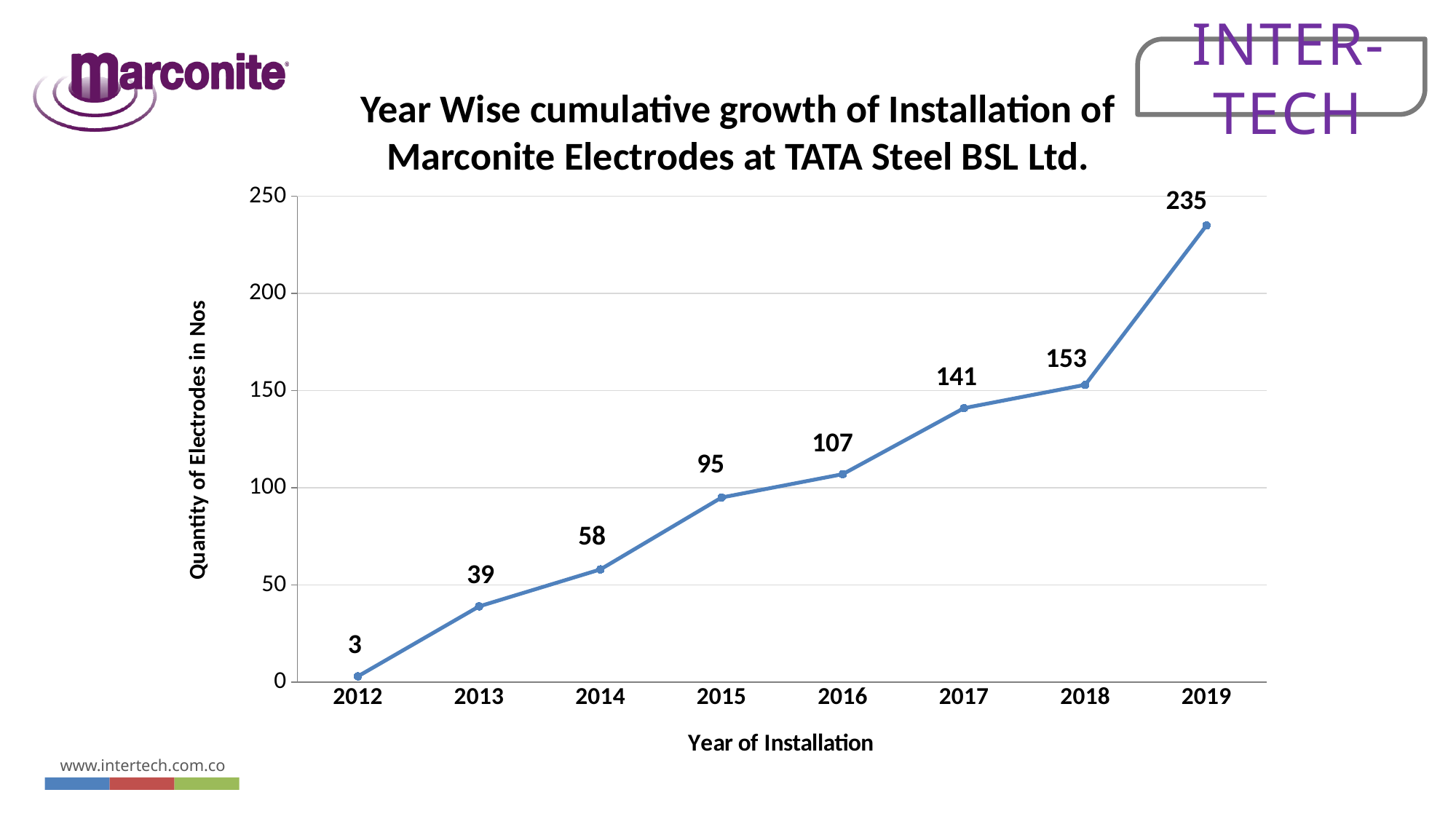
How many years are plotted on the x axis? 8 Which is larger, the value for 2016 or the value for 2017? 2017 What is the difference between the values for 2014 and 2013? 19 What is the value plotted for 2012? 3 Do the values rise or fall from 2012 to 2019? rise Which year has the lowest quantity of electrodes? 2012 What is the difference between the values for 2019 and 2018? 82 Which year has the highest quantity of electrodes? 2019 What is the quantity of electrodes installed by 2015? 95 Is the value for 2018 greater or less than 150? greater What is the value plotted for 2019? 235 What kind of chart is shown on the slide? line chart